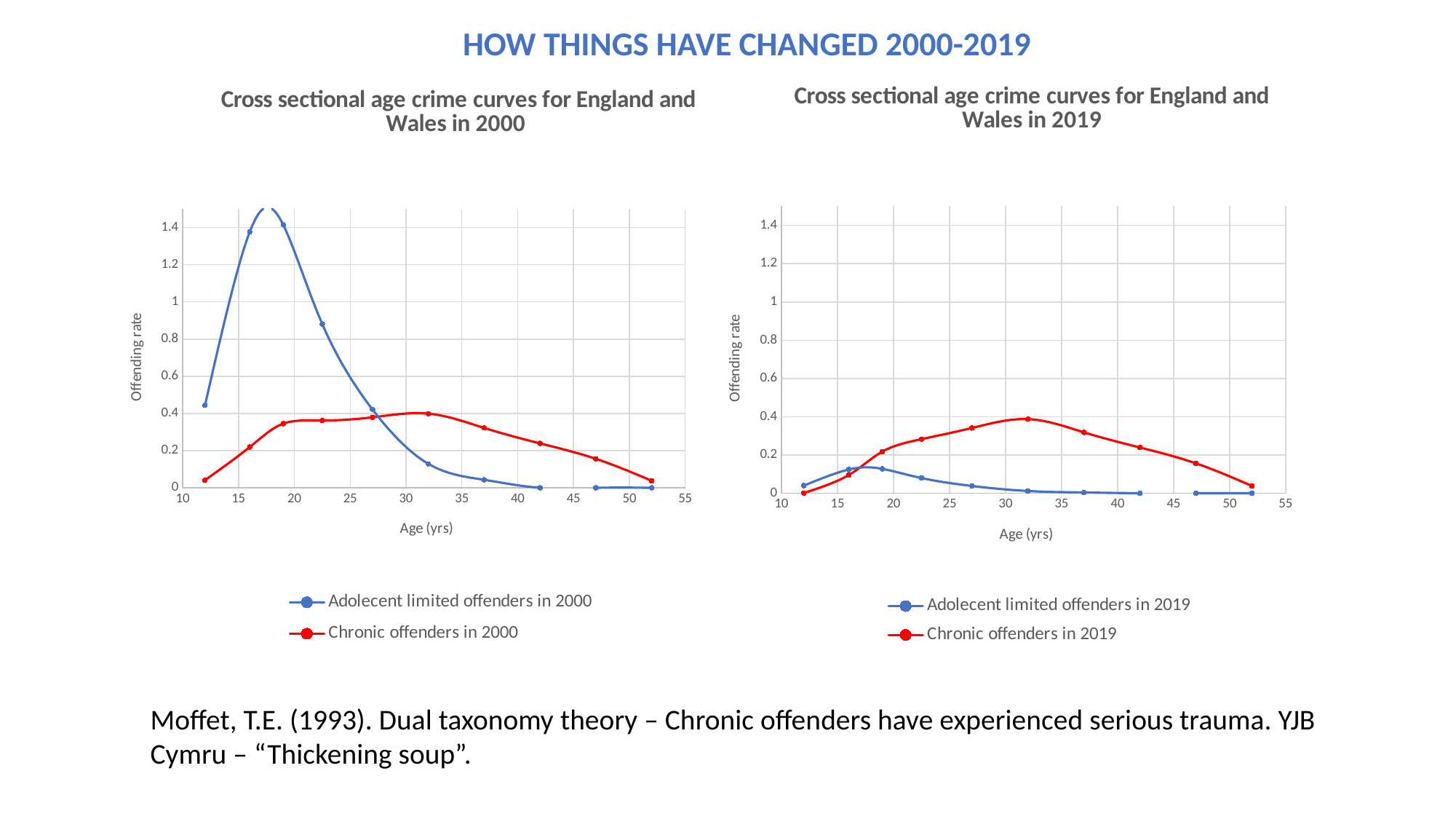
What is the label on the y axis of the left chart (2000)? Offending rate In the right chart (2019), do the values for Chronic offenders rise or fall between age 12 and age 32? rise In the right chart (2019), which series has the higher value at age 32: Adolecent limited offenders or Chronic offenders? Chronic offenders in 2019 In the left chart (2000), is the value for Chronic offenders at age 32 greater or less than 0.6? less In the left chart (2000), which series has the higher value at age 16: Adolecent limited offenders or Chronic offenders? Adolecent limited offenders in 2000 In the left chart (2000), is the value for Adolecent limited offenders at age 16 greater or less than 1? greater What kind of chart is the left chart, 'Cross sectional age crime curves for England and Wales in 2000'? Line chart In the left chart (2000), do the values for Adolecent limited offenders rise or fall between age 19 and age 42? fall How many series does the legend of the right chart, 'Cross sectional age crime curves for England and Wales in 2019', list? 2 In the right chart (2019), is the value for Chronic offenders at age 32 greater or less than 0.2? greater Which colour is used for the Chronic offenders series in the right chart (2019)? Red